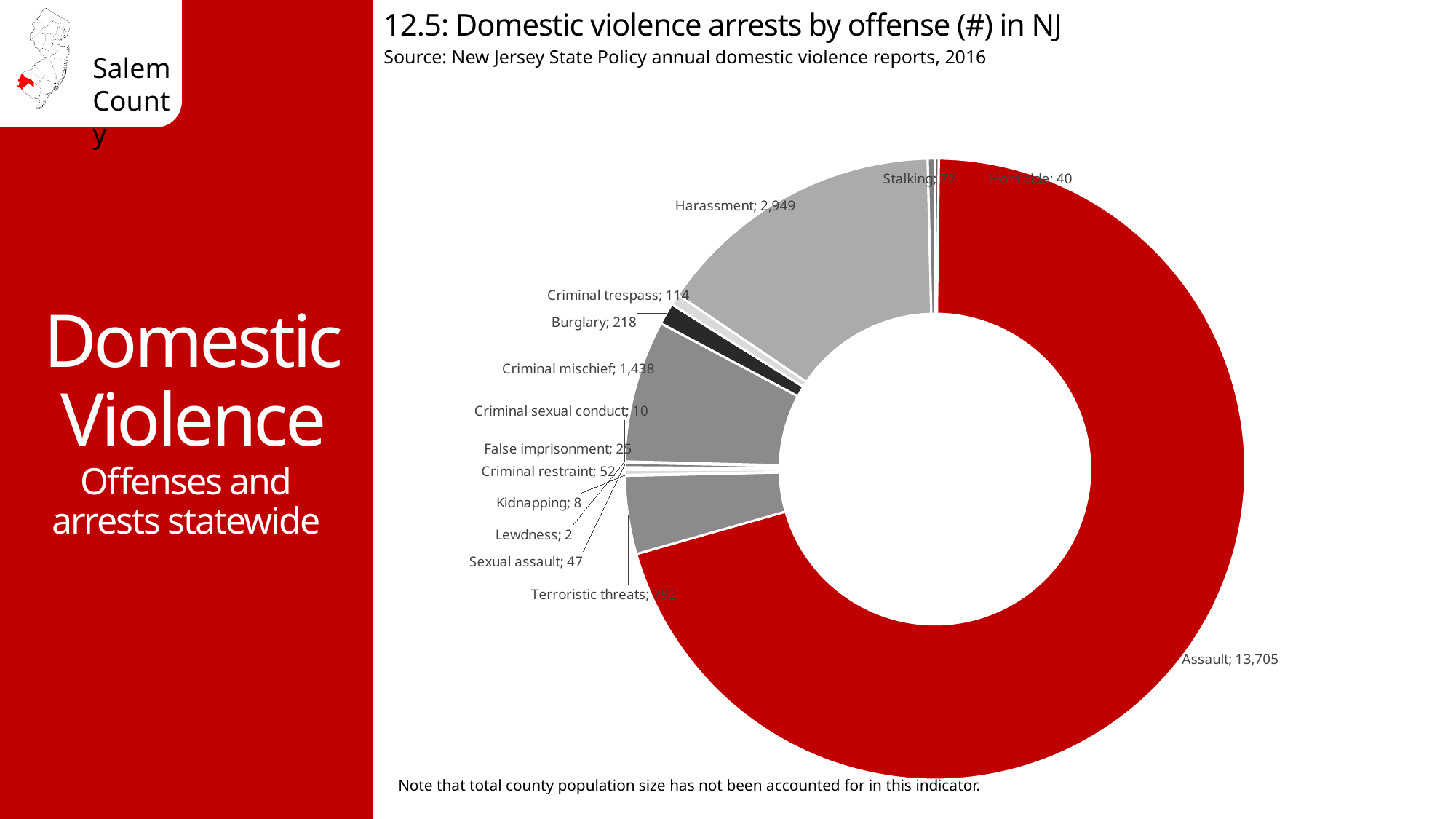
What is the difference between the arrests for Harassment and Criminal mischief? 1,511 Which offense has the highest number of arrests? Assault What is the number of arrests for Homicide? 40 What is the title of the chart? 12.5: Domestic violence arrests by offense (#) in NJ What is the number of domestic violence arrests for Assault? 13,705 Which offense has the lowest number of arrests? Lewdness Which has more arrests, Burglary or Criminal trespass? Burglary What is the number of arrests for Harassment? 2,949 What is the number of arrests for Criminal mischief? 1,438 How many offense categories are shown in the chart? 14 What type of chart is used on this slide? Doughnut chart What is the number of arrests for Burglary? 218